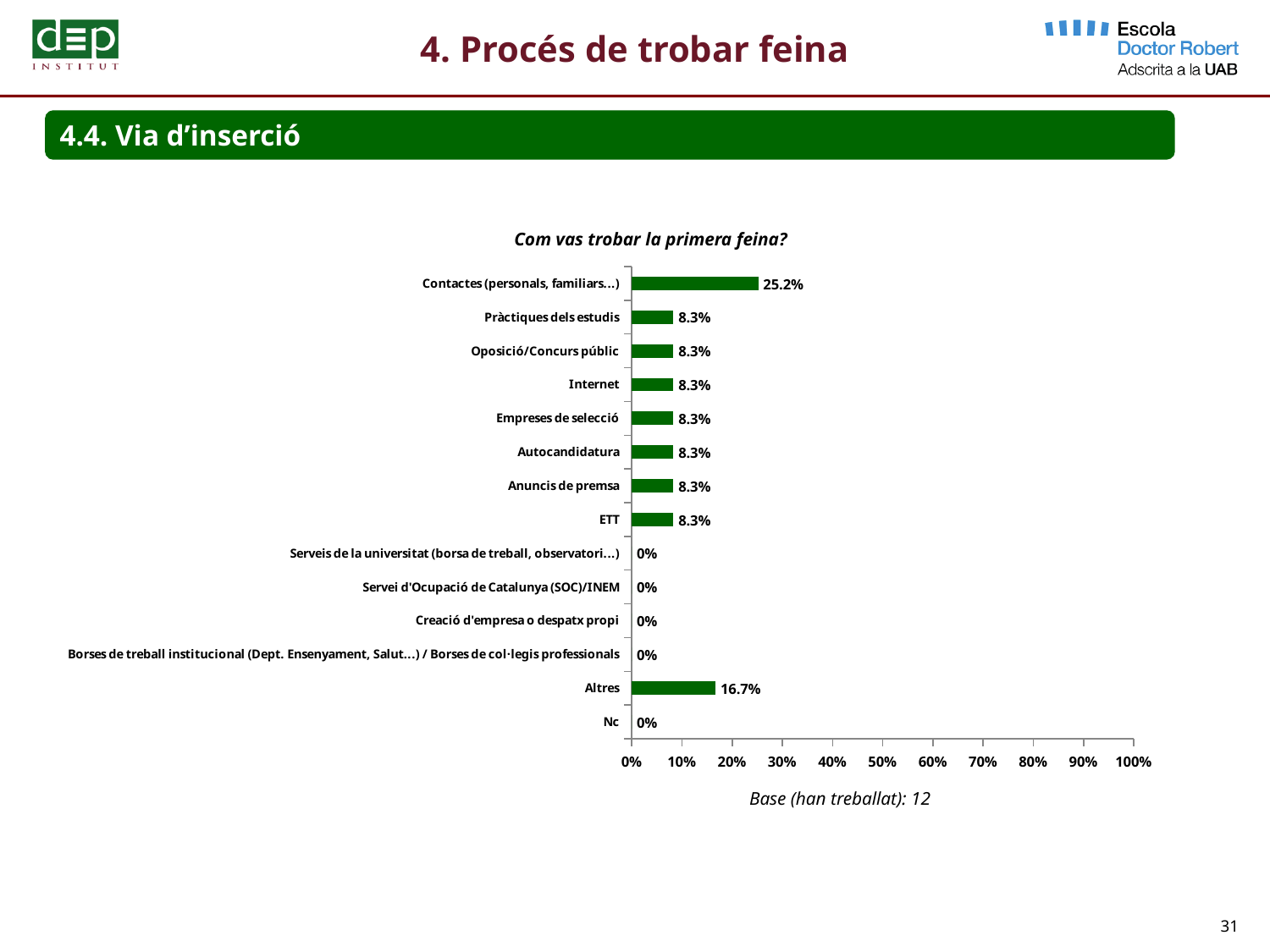
What is the value for "Altres"? 16.7% Which category has the highest value? Contactes (personals, familiars...) Which is larger, the value for "Altres" or the value for "Pràctiques dels estudis"? Altres How many categories are shown in the chart? 14 Is the value for "Contactes (personals, familiars...)" greater or less than 20%? greater What is the value for "Contactes (personals, familiars...)"? 25.2% What is the title of the chart? Com vas trobar la primera feina? What type of chart is shown on the slide? Bar chart What is the difference between the values for "Altres" and "ETT"? 8.4% What is the value for "Internet"? 8.3% What is the value for "Servei d'Ocupació de Catalunya (SOC)/INEM"? 0% What is the difference between the values for "Contactes (personals, familiars...)" and "Altres"? 8.5%